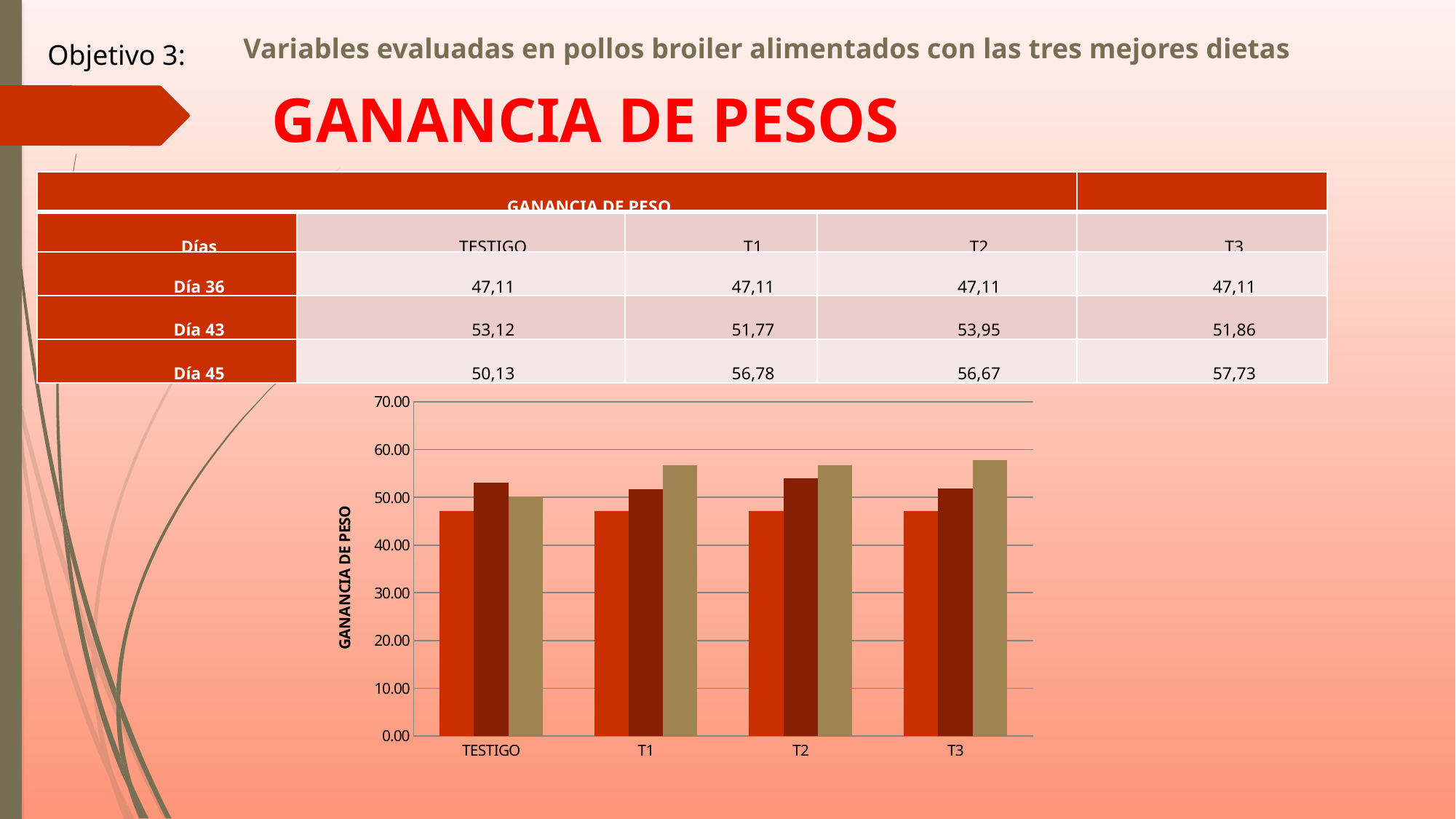
Is the value of the third bar for T3 greater or less than 50? greater Is the value of the second bar for TESTIGO greater or less than 50? greater For T3, which is taller: the first bar or the third bar? the third bar What kind of chart is shown on the slide? bar chart What is the title of the vertical axis of the chart? GANANCIA DE PESO For TESTIGO, which is taller: the second bar or the third bar? the second bar How many categories are shown on the x axis of the chart? 4 Is the value of the third bar for T1 greater or less than 60? less Which category has the shortest third bar in the chart? TESTIGO What is the highest value shown on the vertical axis of the chart? 70.00 How many bars are plotted for each category in the chart? 3